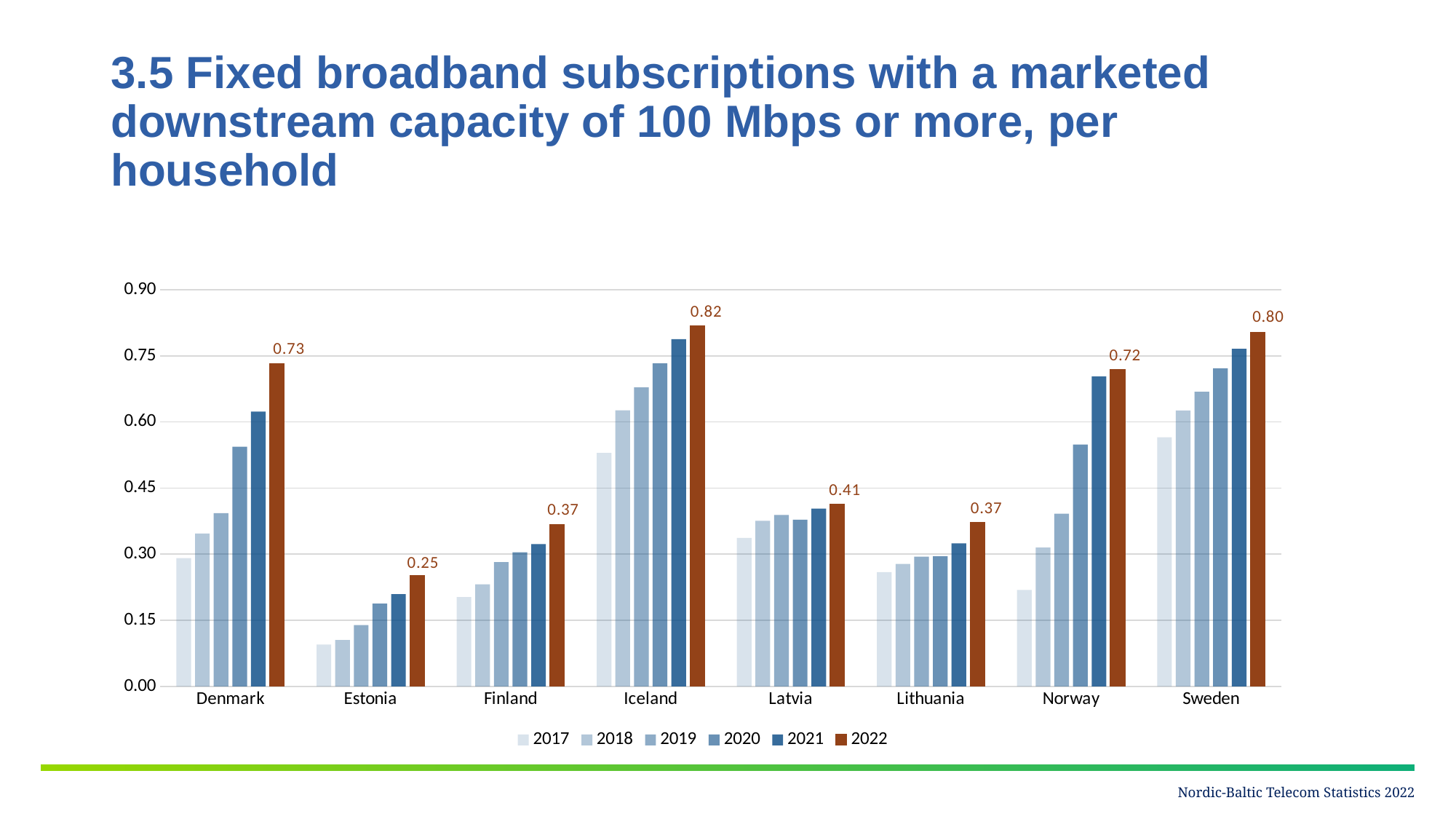
Which country has the highest 2022 value? Iceland Which country has the lowest 2022 value? Estonia Do the values for Denmark rise or fall from 2017 to 2022? Rise What is the 2022 value for Estonia? 0.25 What is the 2022 value for Iceland? 0.82 What kind of chart is shown on the slide? Bar chart How many countries are shown on the x axis? 8 How many series does the legend list? 6 Is the 2017 value for Iceland greater or less than 0.45? greater Is the 2017 value for Estonia greater or less than 0.15? less What is the difference between the 2022 values for Sweden and Denmark? 0.07 Which is larger, the 2022 value for Norway or the 2022 value for Latvia? Norway